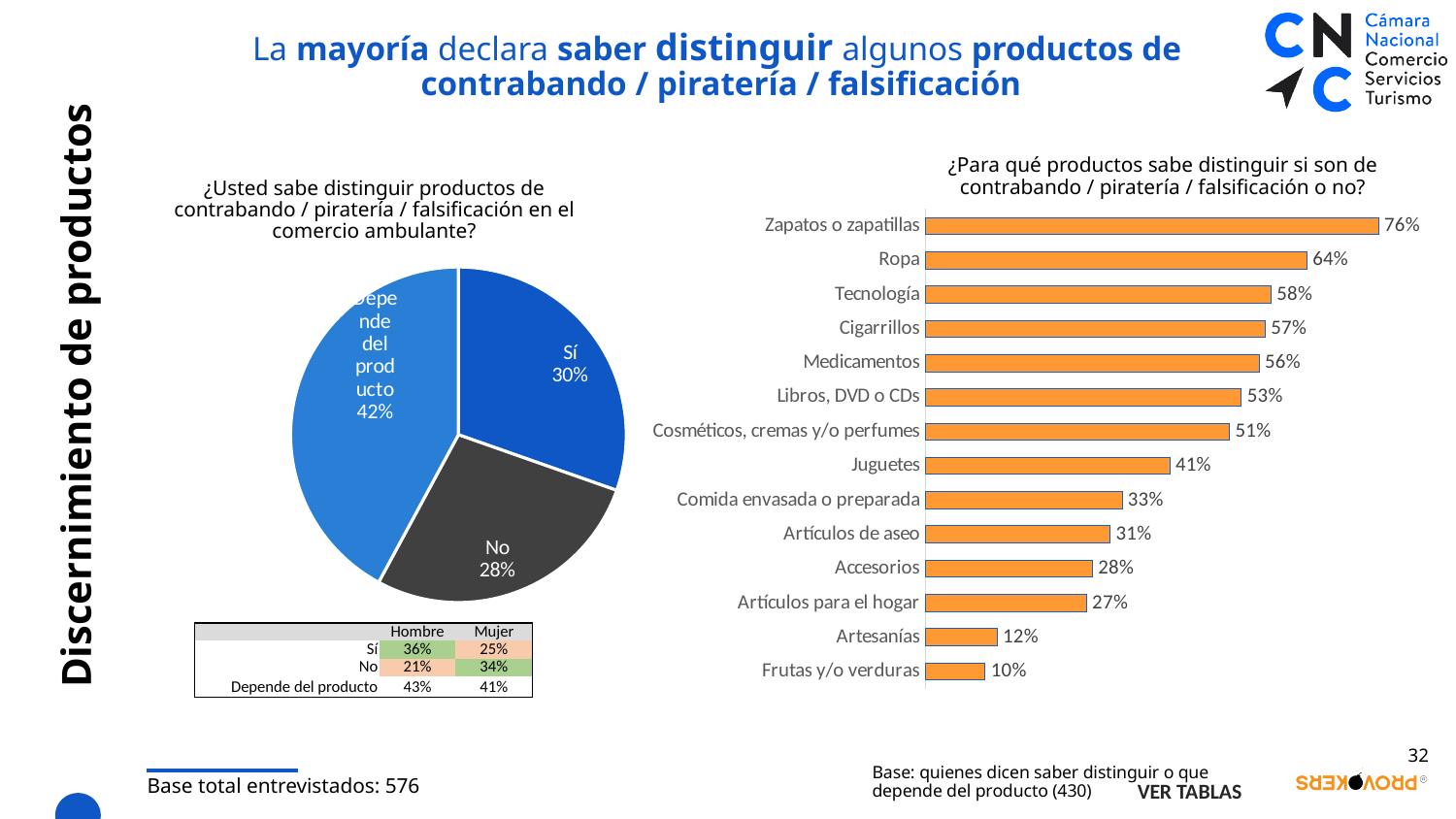
In the bar chart on the right, what percentage is shown for Zapatos o zapatillas? 76% In the bar chart on the right, do the values increase or decrease from top to bottom? decrease In the pie chart on the left, which response has the largest slice? Depende del producto In the bar chart on the right, which has a higher percentage, Juguetes or Artículos de aseo? Juguetes In the pie chart on the left, what percentage answered 'No'? 28% In the pie chart on the left, what share of respondents answered 'Depende del producto'? 42% In the bar chart on the right, what percentage is shown for Medicamentos? 56% In the bar chart on the right, which product has the lowest percentage? Frutas y/o verduras What type of chart is shown on the left side of the slide? pie chart In the bar chart on the right, which product has the highest percentage? Zapatos o zapatillas In the bar chart on the right, what is the difference between the percentages for Ropa and Tecnología? 6% How many product categories are shown in the bar chart on the right? 14